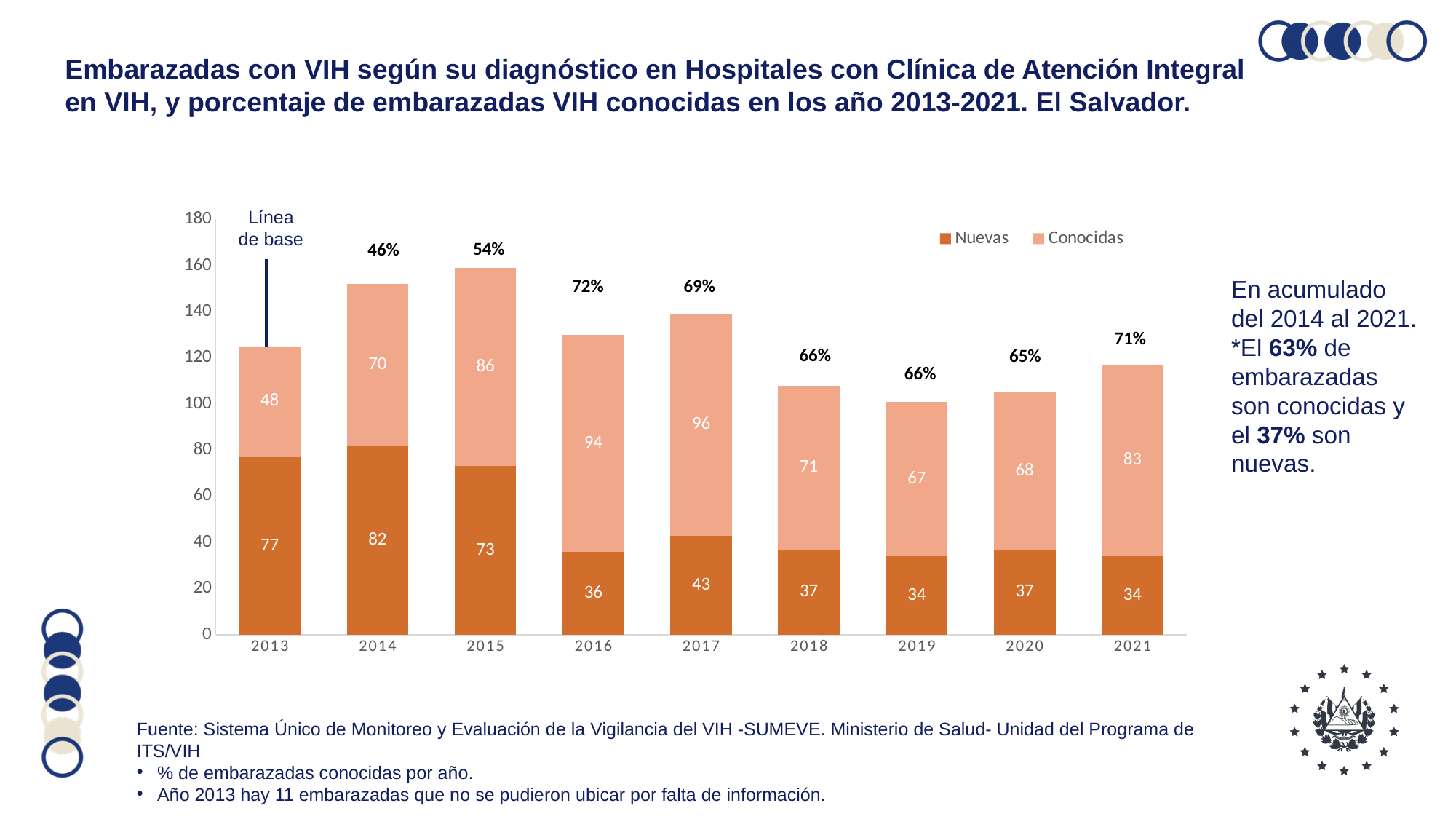
What is the difference between the Conocidas values for 2017 and 2013? 48 What is the value for Conocidas in 2016? 94 What kind of chart is shown on the slide? Stacked bar chart Which year has the highest value for Conocidas? 2017 What is the total of the stacked bar for 2015? 159 Which year has the lowest value for Conocidas? 2013 How many series does the legend list? 2 How many years are shown on the x axis? 9 What is the value for Nuevas in 2014? 82 Which is larger, the Nuevas value for 2013 or for 2016? 2013 Which year has the highest value for Nuevas? 2014 What percentage is shown above the bar for 2021? 71%